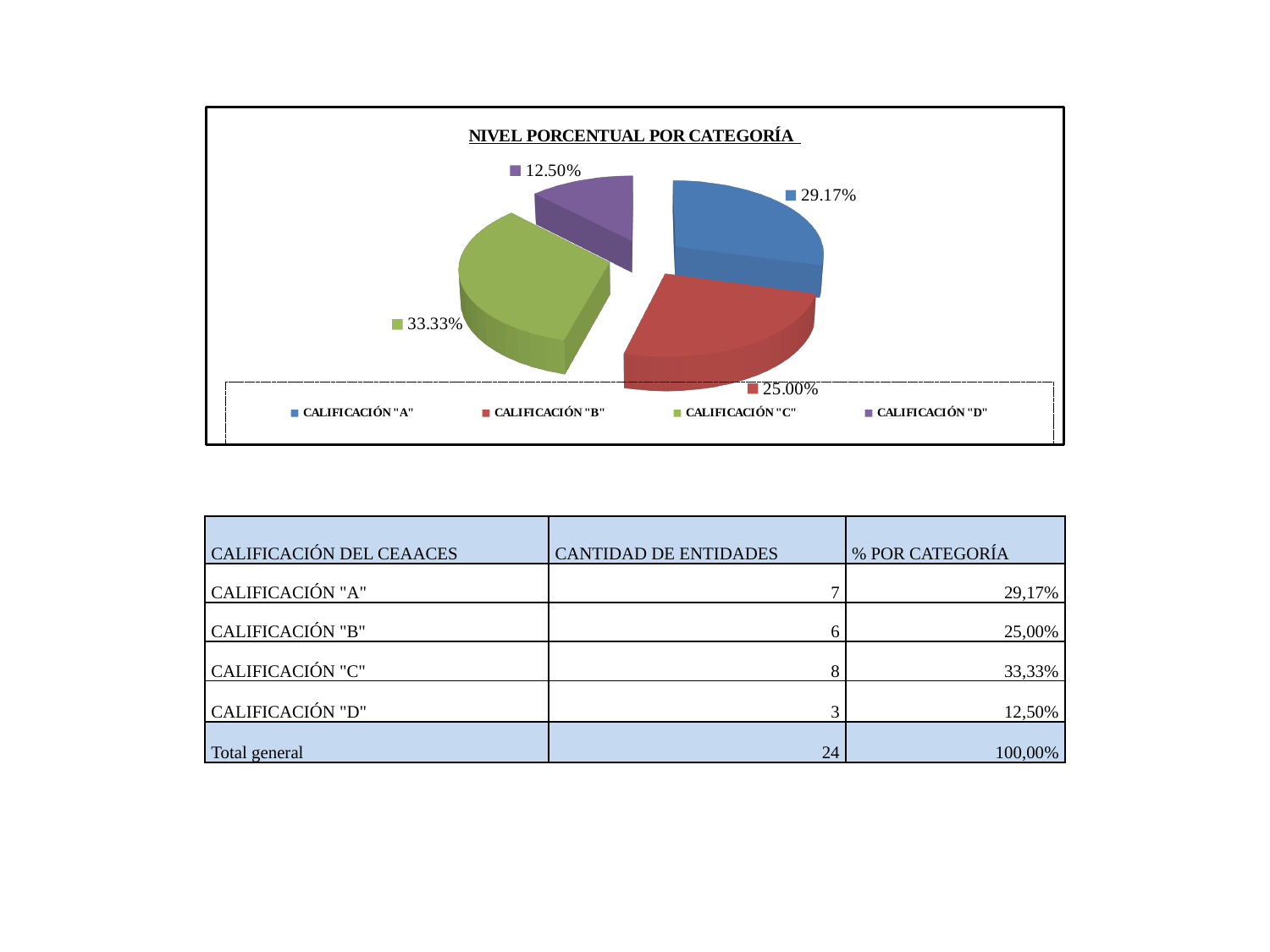
What percentage does the slice for CALIFICACIÓN "A" show? 29.17% What percentage does the slice for CALIFICACIÓN "D" show? 12.50% What is the difference in percentage points between the CALIFICACIÓN "C" slice and the CALIFICACIÓN "D" slice? 20.83% How many entries does the legend list? 4 Which category has the smallest slice of the pie? CALIFICACIÓN "D" What percentage does the slice for CALIFICACIÓN "B" show? 25.00% What percentage does the slice for CALIFICACIÓN "C" show? 33.33% How many slices does the pie chart have? 4 Which category has the largest slice of the pie? CALIFICACIÓN "C" Which slice is larger, CALIFICACIÓN "A" or CALIFICACIÓN "B"? CALIFICACIÓN "A" What type of chart is shown on the slide? Pie chart What is the title of the chart? NIVEL PORCENTUAL POR CATEGORÍA